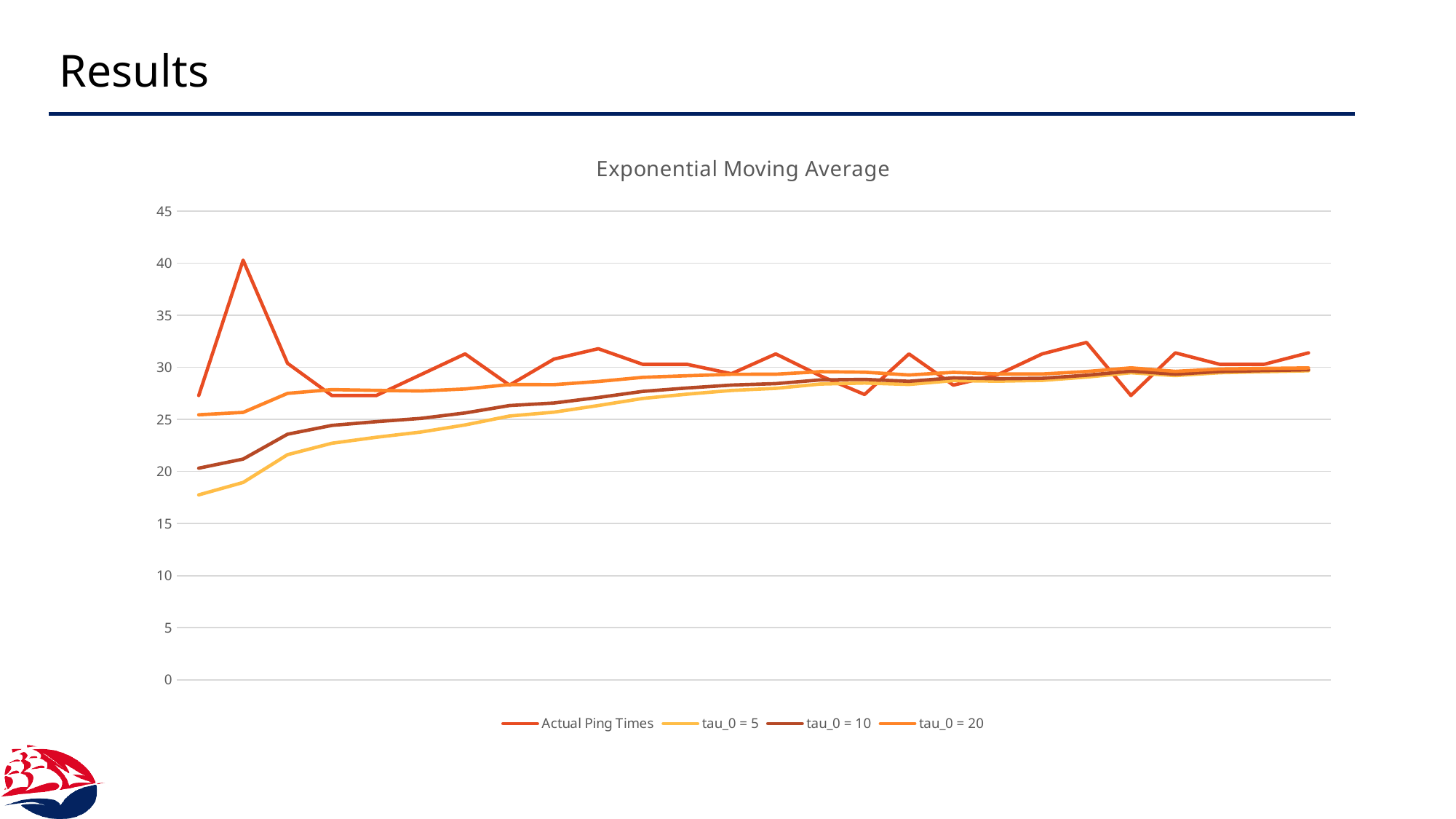
At the first point on the x axis, which is larger: tau_0 = 20 or tau_0 = 5? tau_0 = 20 What is the highest value shown on the y axis? 45 Which series reaches the highest value anywhere on the chart? Actual Ping Times Is the peak value of the Actual Ping Times series greater or less than 35? greater Does the tau_0 = 10 series generally rise or fall along the x axis? rise Does the tau_0 = 5 series generally rise or fall along the x axis? rise Which series has the lowest value at the first point on the x axis? tau_0 = 5 What is the title of the chart? Exponential Moving Average What kind of chart is shown on the slide? line chart Is the first value of the tau_0 = 5 series greater or less than 20? less How many series does the legend list? 4 Is the first value of the tau_0 = 20 series greater or less than 30? less